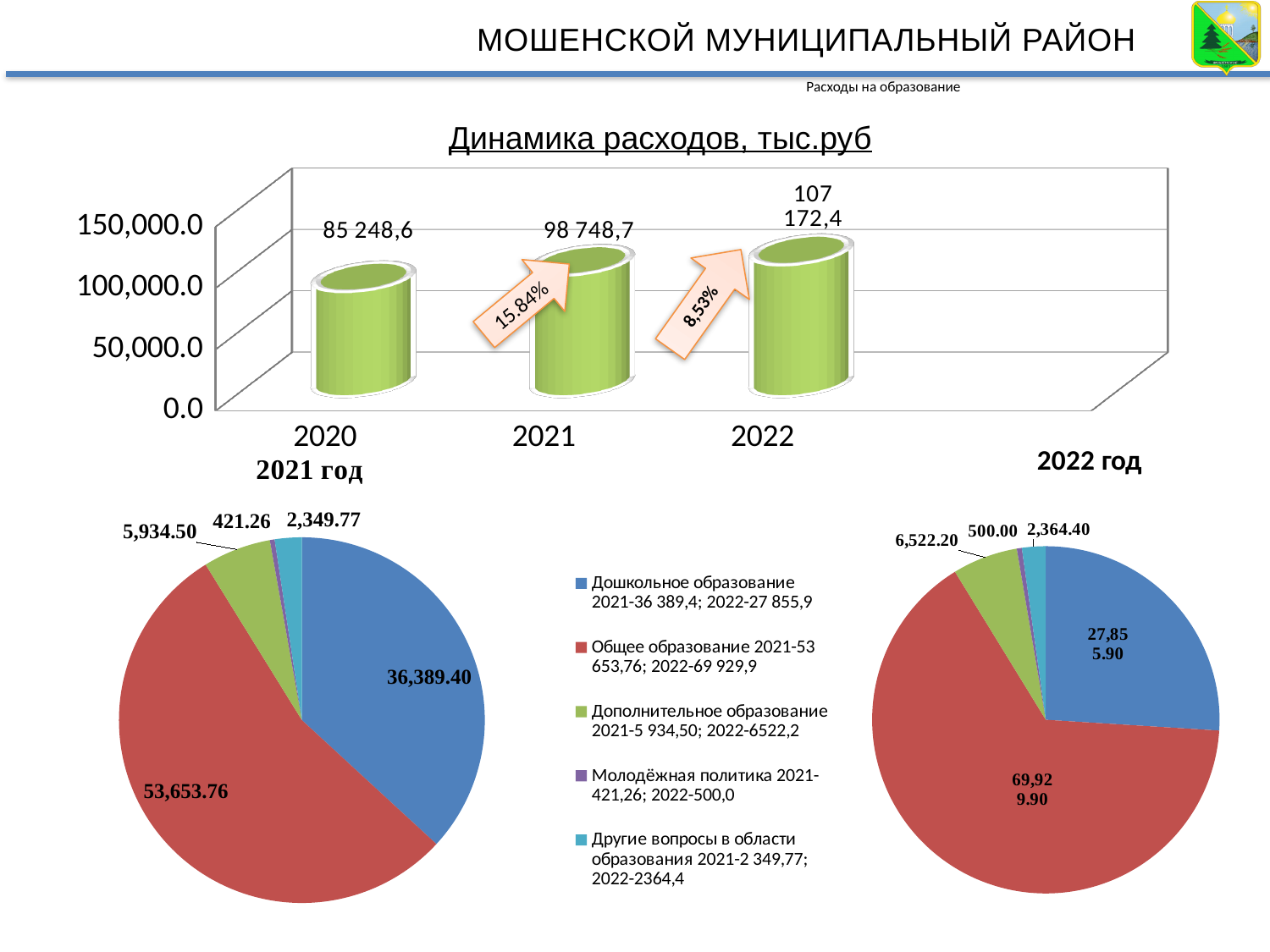
In the pie chart '2021 год', what is the value for Общее образование? 53,653.76 In the pie chart '2022 год', which category has the largest slice? Общее образование How many categories does the legend of the pie charts list? 5 In the chart 'Динамика расходов, тыс.руб', do the values rise or fall from 2020 to 2022? rise In the pie chart '2022 год', what is the value for Дополнительное образование? 6,522.20 In the chart 'Динамика расходов, тыс.руб', what is the value for 2022? 107 172,4 In the pie chart '2021 год', which category has the smallest slice? Молодёжная политика In the chart 'Динамика расходов, тыс.руб', how many years are shown? 3 In the chart 'Динамика расходов, тыс.руб', is the value for 2021 greater or less than 100,000.0? less In the chart 'Динамика расходов, тыс.руб', which year has the lowest value? 2020 In the chart 'Динамика расходов, тыс.руб', what is the value for 2020? 85 248,6 What kind of chart is 'Динамика расходов, тыс.руб'? bar chart